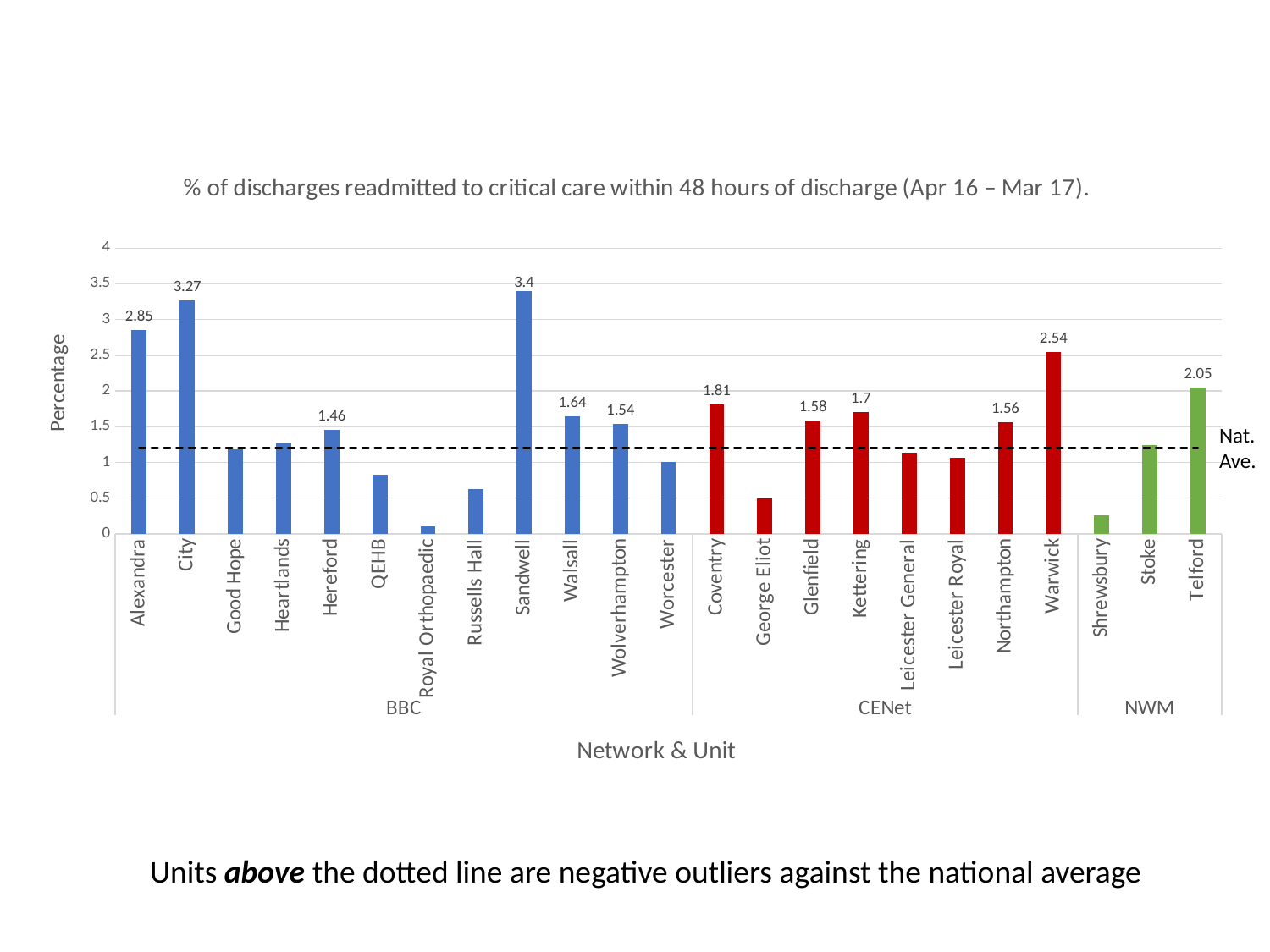
What is the value for Warwick? 2.54 What kind of chart is shown on the slide? bar chart Is the value for QEHB greater or less than 1? less How many units are shown on the x axis? 23 What is the value for Sandwell? 3.4 Which unit has the highest percentage of discharges readmitted? Sandwell What does the dotted horizontal line represent? Nat. Ave. What is the difference between the values for City and Alexandra? 0.42 Is the value for Shrewsbury greater or less than 0.5? less Which is larger, the value for Coventry or the value for Kettering? Coventry What is the value for Telford? 2.05 Which unit has the lowest percentage of discharges readmitted? Royal Orthopaedic